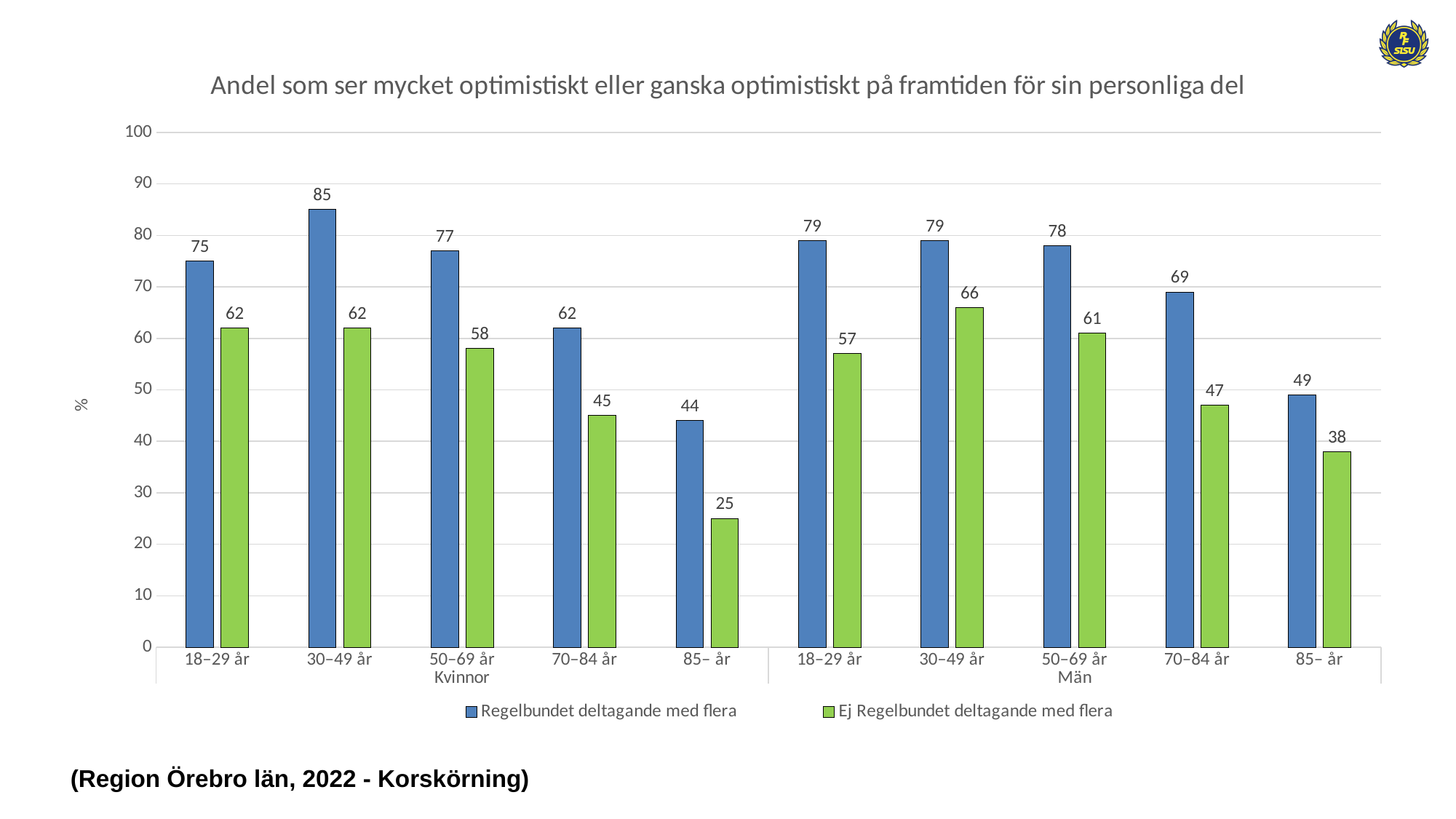
How many age groups are shown for Män? 5 How many series does the legend list? 2 What is the value for 'Regelbundet deltagande med flera' for Kvinnor 30–49 år? 85 What is the value for 'Ej Regelbundet deltagande med flera' for Män 85– år? 38 What kind of chart is shown on the slide? Bar chart What is the difference between 'Regelbundet deltagande med flera' and 'Ej Regelbundet deltagande med flera' for Män 18–29 år? 22 Which group has the lowest value for 'Ej Regelbundet deltagande med flera'? Kvinnor 85– år What is the difference between the two series for Kvinnor 85– år? 19 What is the value for 'Ej Regelbundet deltagande med flera' for Kvinnor 70–84 år? 45 Do the values for 'Regelbundet deltagande med flera' rise or fall from 50–69 år to 85– år among Män? Fall Which is larger: 'Ej Regelbundet deltagande med flera' for Män 30–49 år or for Kvinnor 30–49 år? Män 30–49 år Which group has the highest value for 'Regelbundet deltagande med flera'? Kvinnor 30–49 år